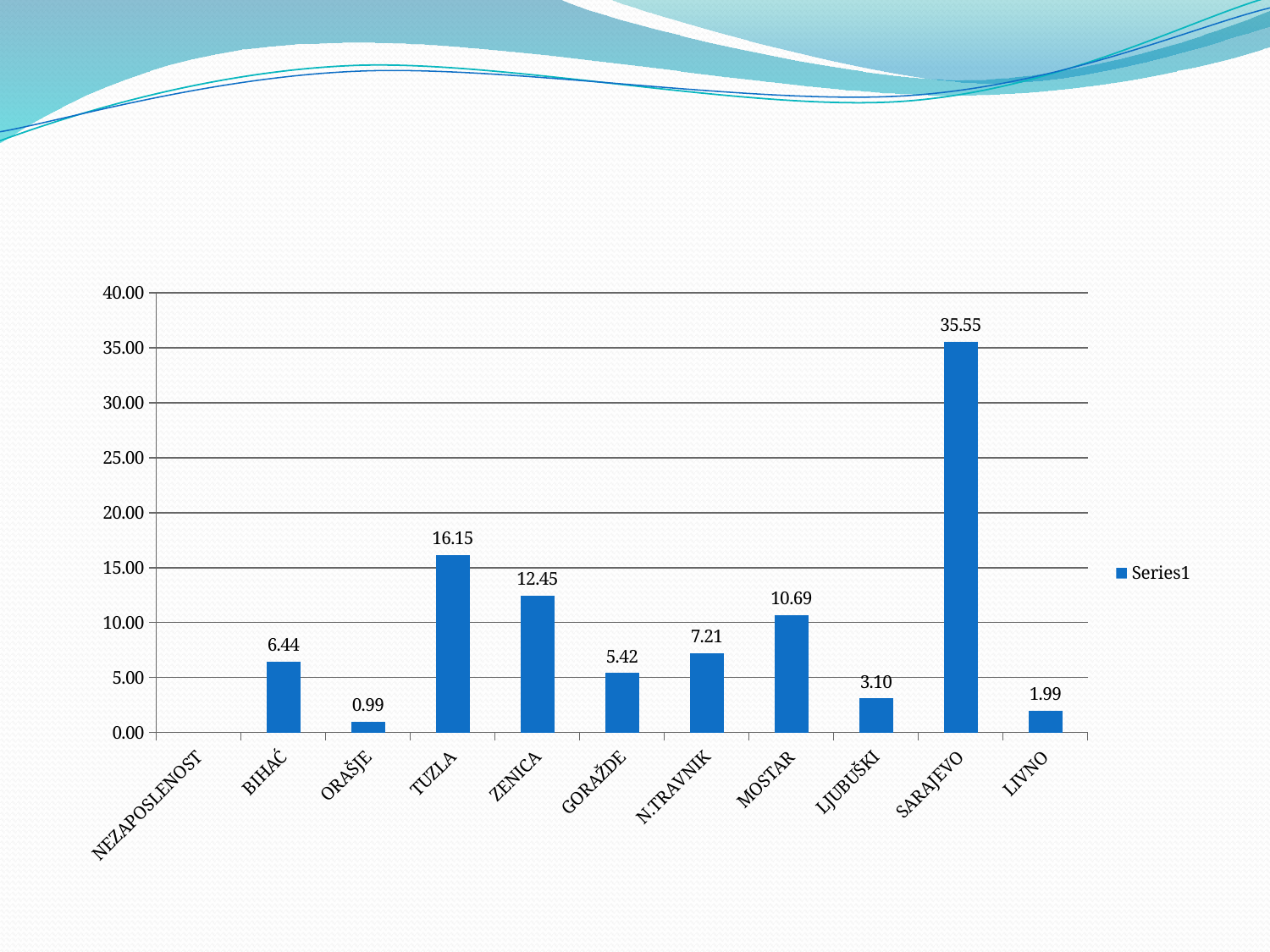
How many bars are plotted on the chart? 10 What is the difference between the values for MOSTAR and N.TRAVNIK? 3.48 What is the value for LJUBUŠKI? 3.10 What is the difference between the values for SARAJEVO and TUZLA? 19.40 Which category with a plotted bar has the lowest value? ORAŠJE What is the value for SARAJEVO? 35.55 Which is larger, the value for BIHAĆ or the value for GORAŽDE? BIHAĆ Is the value for TUZLA greater or less than 15.00? greater How many series does the legend list? 1 What is the value for ZENICA? 12.45 Which category has the highest value? SARAJEVO What kind of chart is shown on the slide? bar chart